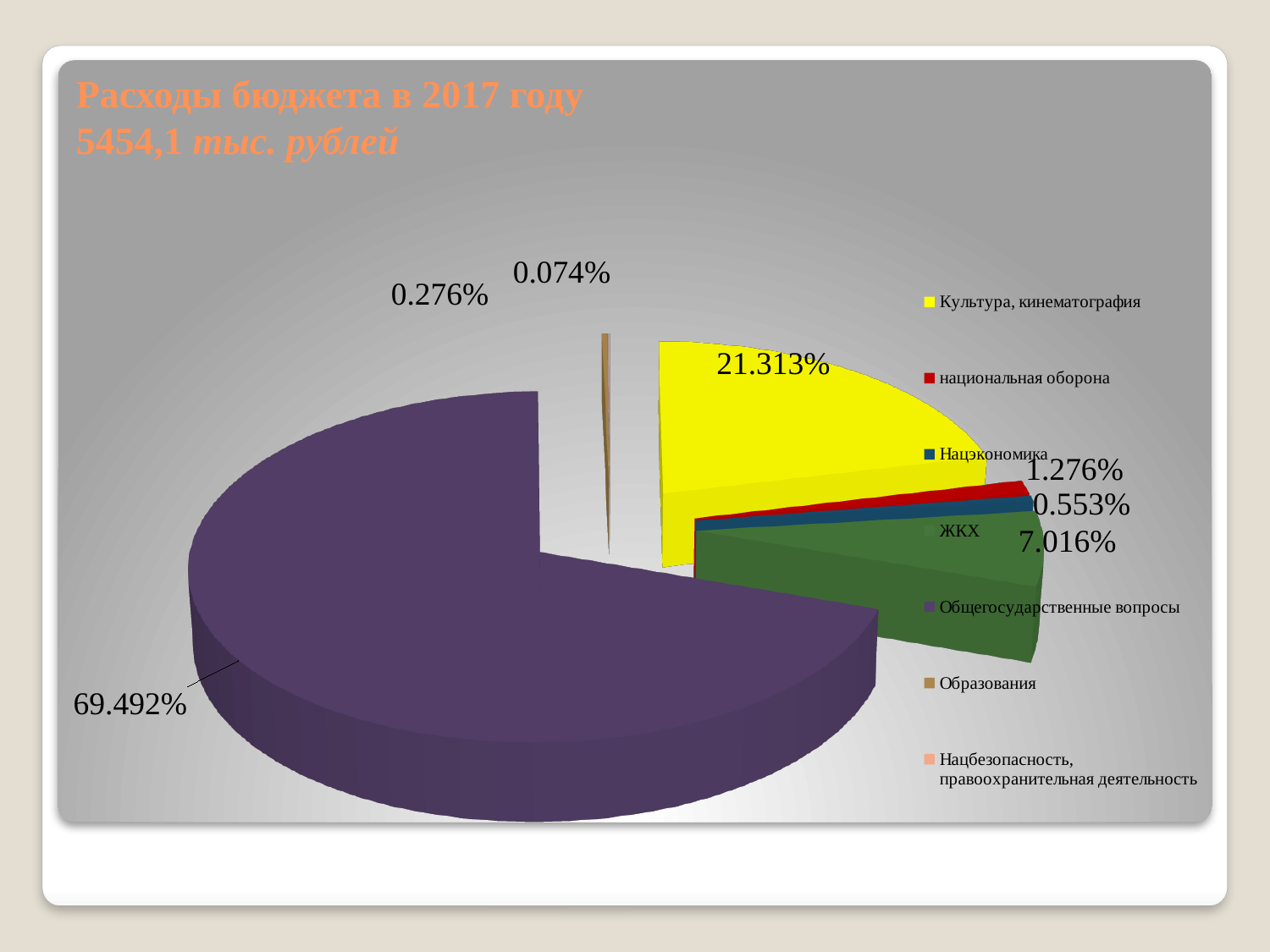
What is the value shown for Культура, кинематография? 21.313% What kind of chart is shown on the slide? pie chart Which category has the largest share of the pie? Общегосударственные вопросы What is the value shown for Нацэкономика? 0.553% What colour is the slice for Культура, кинематография? yellow What is the difference between the share for Общегосударственные вопросы and the share for Культура, кинематография? 48.179% What share of the pie does Общегосударственные вопросы take? 69.492% How many categories does the legend of the pie chart list? 7 What is the title of the slide containing the pie chart? Расходы бюджета в 2017 году 5454,1 тыс. рублей Which is larger, the share for Культура, кинематография or the share for ЖКХ? Культура, кинематография What is the value shown for ЖКХ? 7.016% What is the value shown for национальная оборона? 1.276%